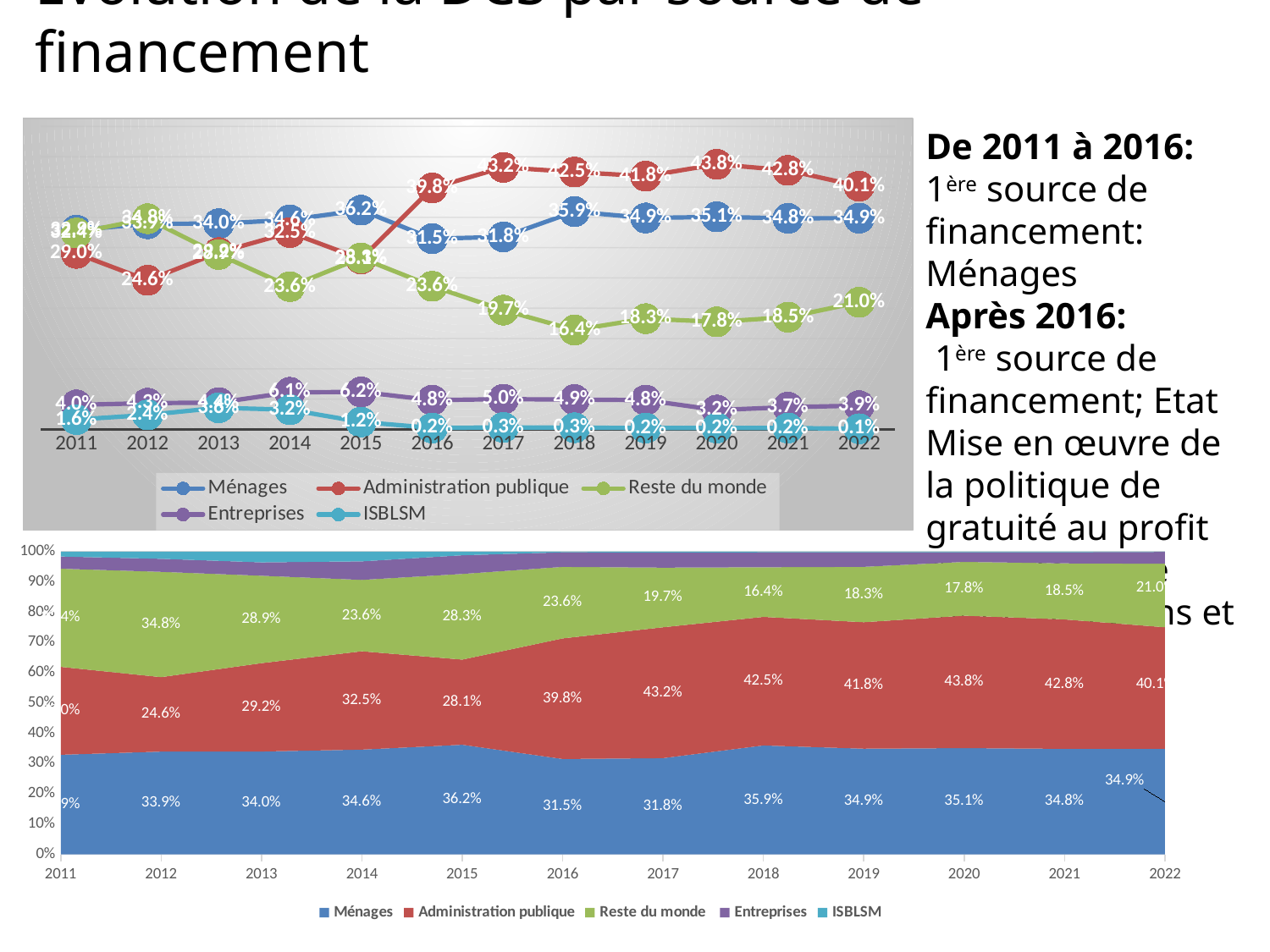
In the top line chart, does the Reste du monde series rise or fall from 2012 to 2018? Fall In the top line chart, what is the value for Ménages in 2015? 36.2% In the top line chart, what is the value for Administration publique in 2017? 43.2% In the bottom stacked area chart, which is larger in 2022: Administration publique or Ménages? Administration publique In the top line chart, what is the difference between the Administration publique values for 2016 and 2015? 11.7 percentage points In the top line chart, how many series does the legend list? 5 In the top line chart, what is the value for ISBLSM in 2022? 0.1% In the top line chart, in which year is Administration publique at its highest? 2020 What kind of chart is the bottom chart on the slide? Stacked area chart In the top line chart, in which year is Reste du monde at its lowest? 2018 In the bottom stacked area chart, how many years are shown on the x axis? 12 What kind of chart is the top chart on the slide? Line chart